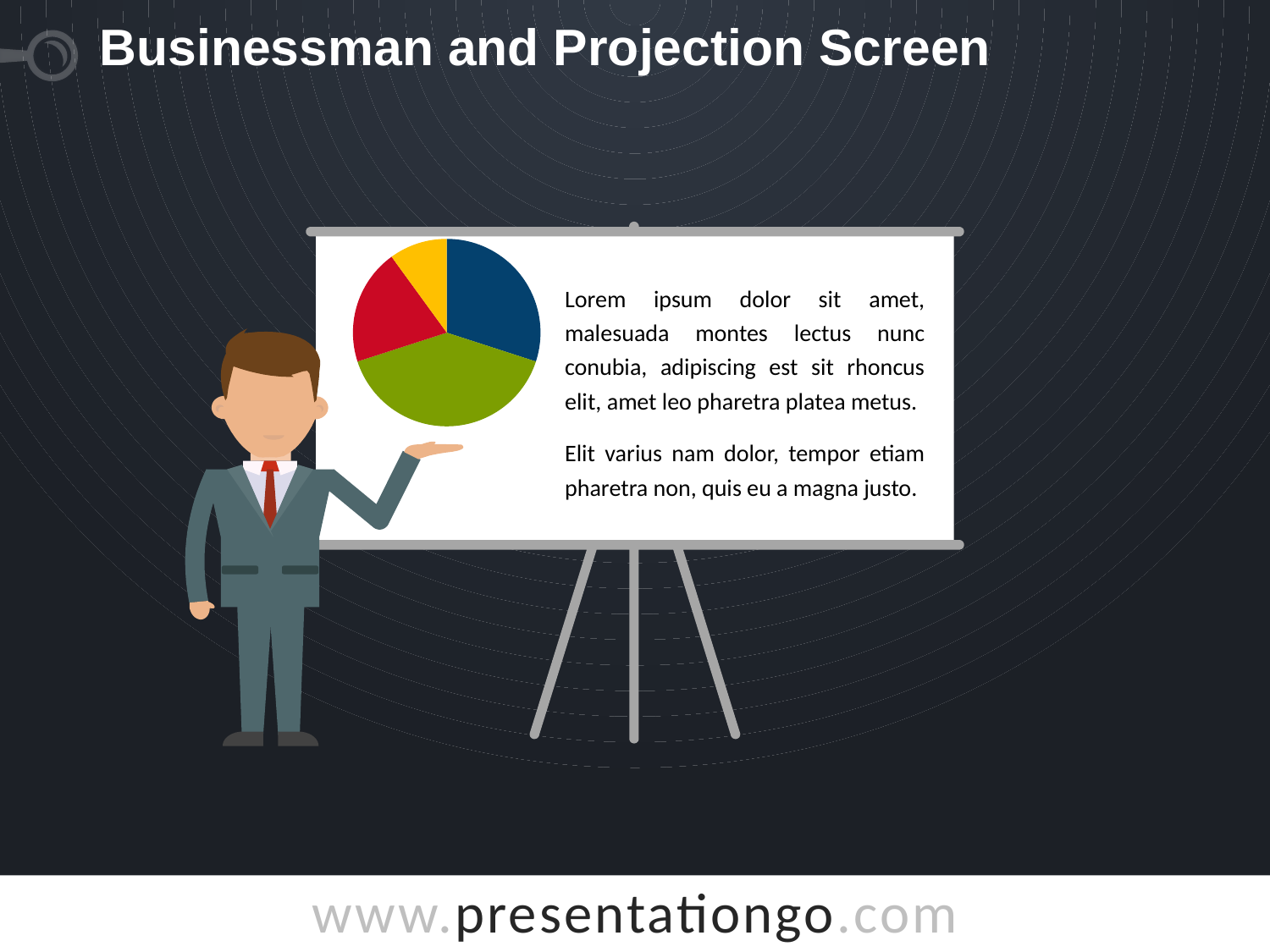
In the pie chart on the projection screen, is the green slice larger or smaller than the yellow slice? larger How many slices does the pie chart on the projection screen have? 4 Which colour slice is the largest in the pie chart on the projection screen? green In the pie chart on the projection screen, is the blue slice larger or smaller than the yellow slice? larger Does the pie chart on the projection screen show a legend? No What kind of chart is shown on the projection screen? pie chart What colours are the slices of the pie chart on the projection screen? blue, green, red, yellow Which colour slice is the smallest in the pie chart on the projection screen? yellow